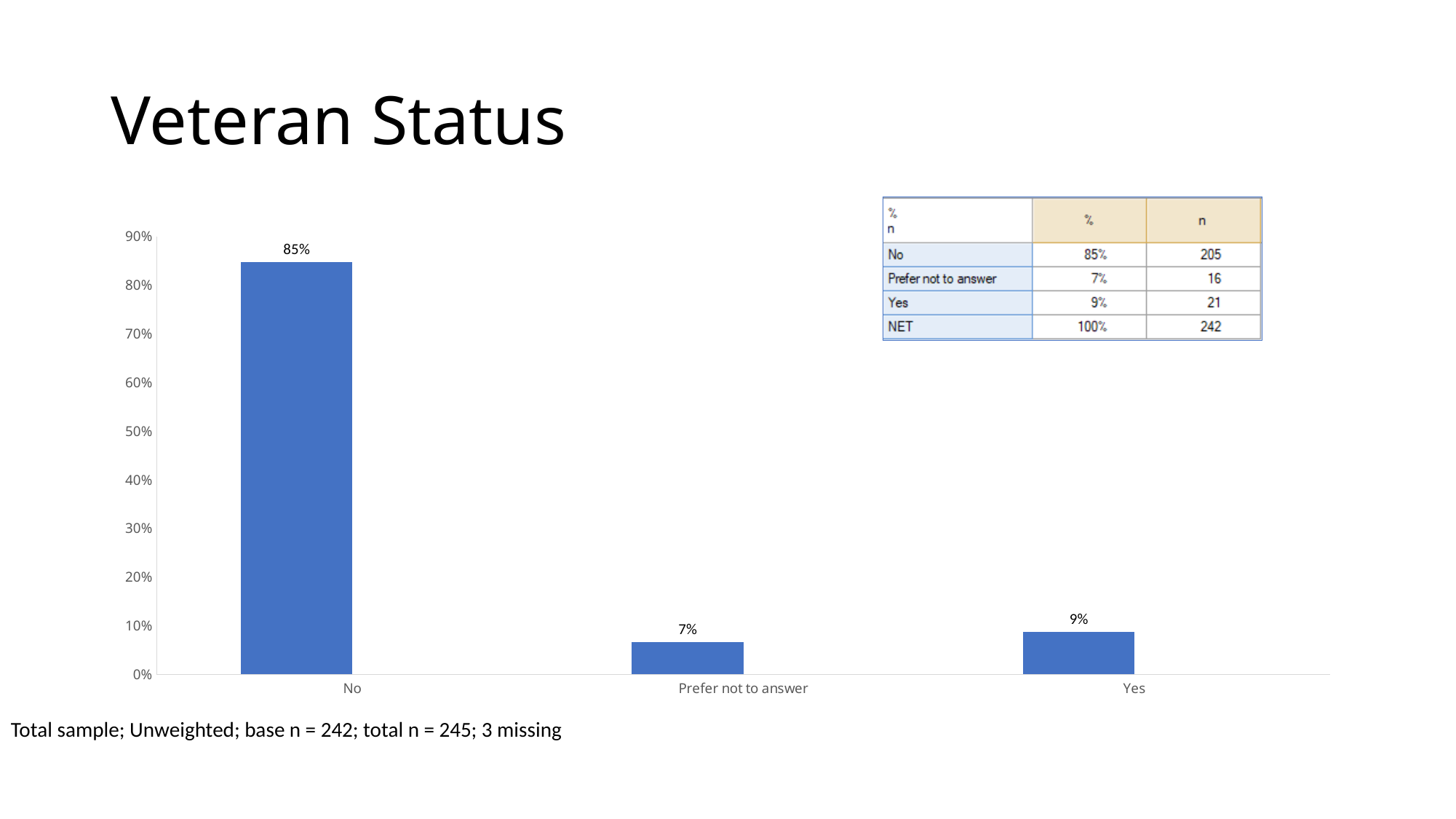
What is the value for No? 85% Is the value for No greater or less than 80%? greater What is the difference between the values for No and Yes? 76% What is the difference between the values for Yes and Prefer not to answer? 2% Which category has the highest value? No What is the value for Yes? 9% Which is larger, the value for Yes or the value for Prefer not to answer? Yes What kind of chart is shown on the slide? bar chart Which category has the lowest value? Prefer not to answer What is the value for Prefer not to answer? 7% How many categories are shown on the x axis? 3 What is the title of the slide containing the chart? Veteran Status